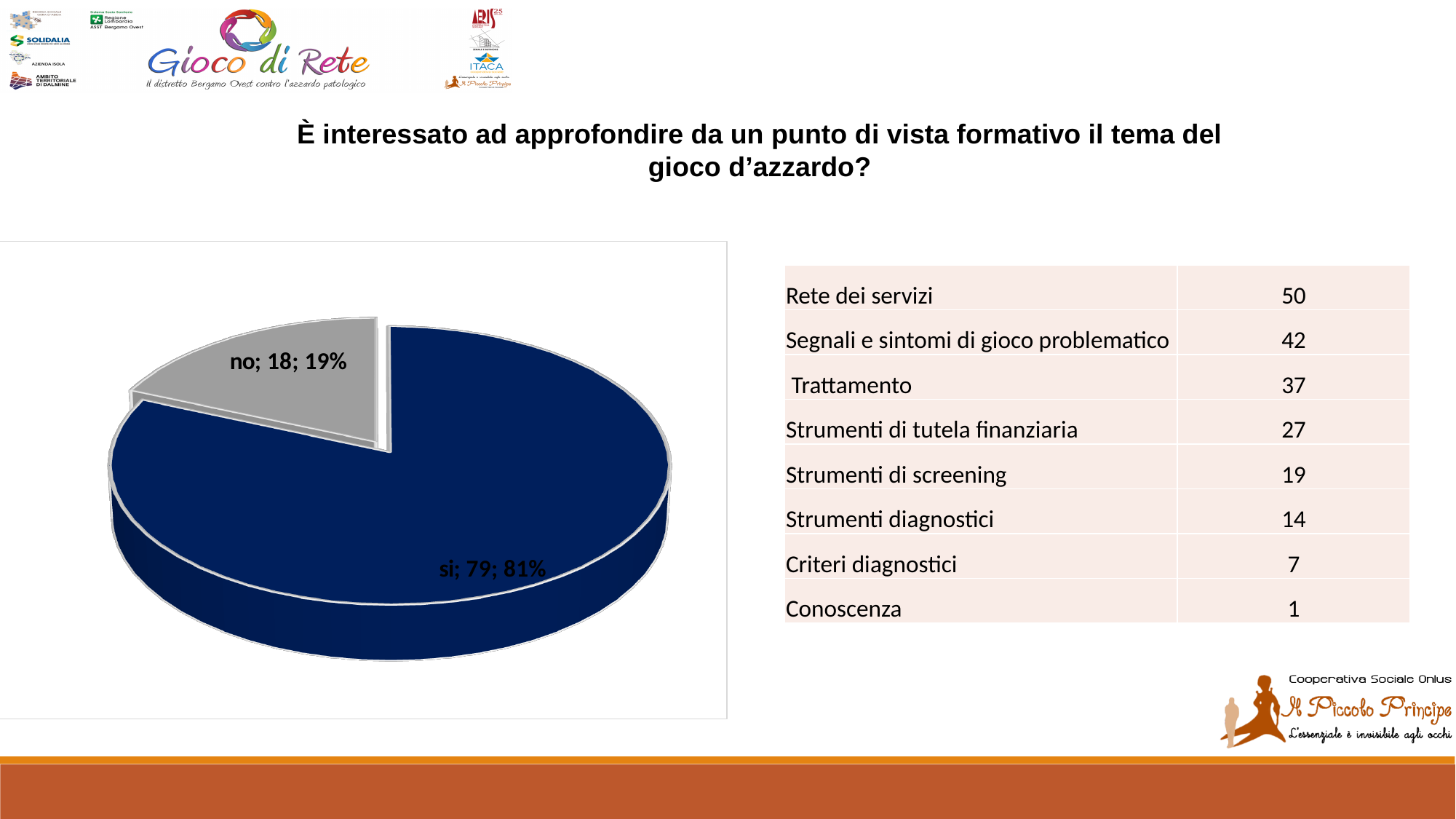
What share of the pie does the "no" slice represent? 19% What kind of chart is shown on the slide? pie chart Which is larger in the pie chart, the "si" value or the "no" value? si How many slices does the pie chart have? 2 Which slice of the pie chart is the smallest? no What colour is the "no" slice in the pie chart? grey What share of the pie does the "si" slice represent? 81% What is the value for the "no" slice in the pie chart? 18 Which slice of the pie chart is the largest? si What is the value for the "si" slice in the pie chart? 79 What is the difference between the "si" and "no" values in the pie chart? 61 What colour is the "si" slice in the pie chart? dark blue